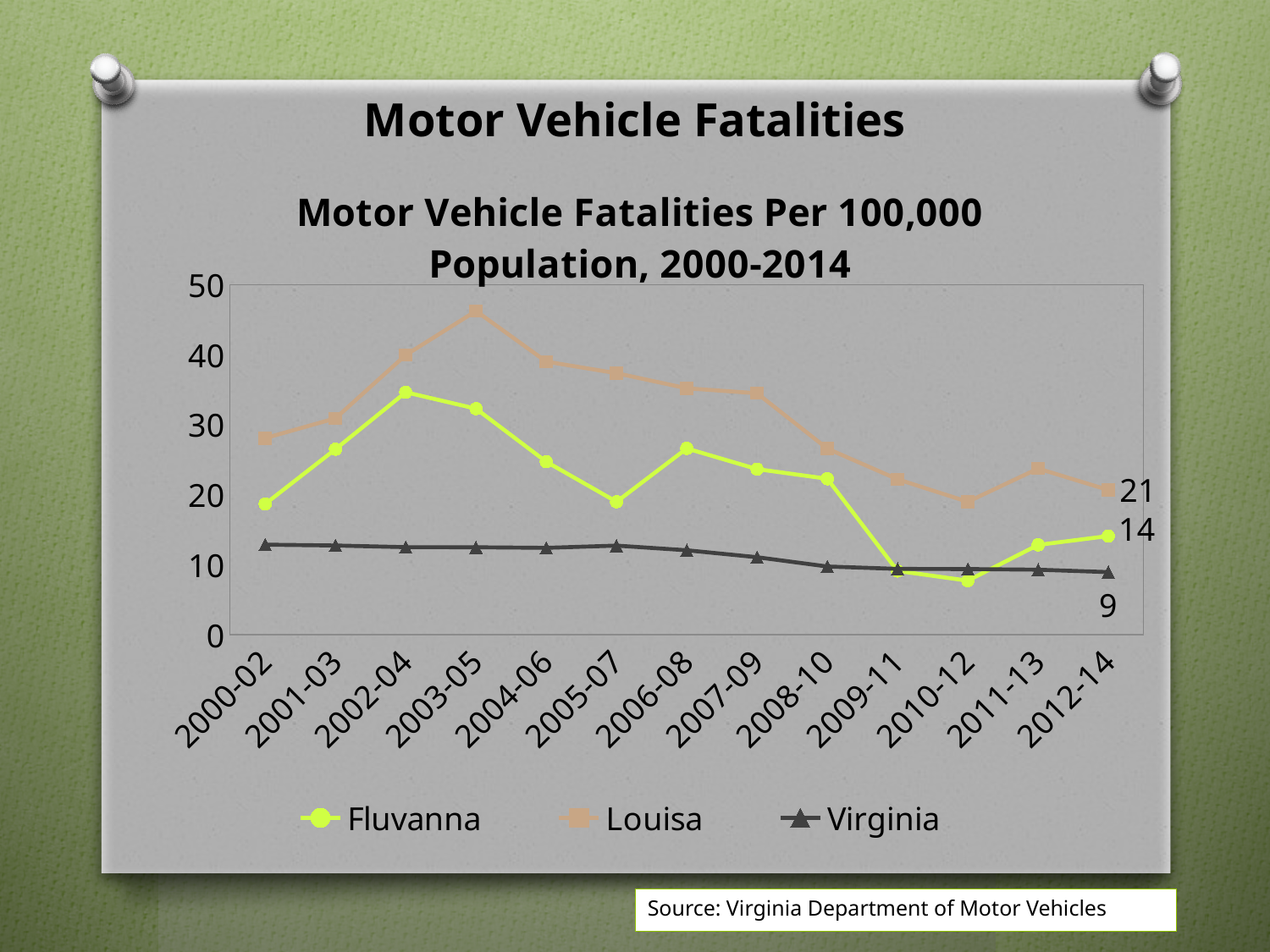
Is the value for Louisa in 2003-05 greater or less than 40? greater In 2012-14, which is larger, the Louisa value or the Virginia value? Louisa How many series does the legend list? 3 What is the value for Fluvanna in 2012-14? 14 What is the value for Louisa in 2012-14? 21 What kind of chart is shown on the slide? Line chart Is the value for Fluvanna in 2010-12 greater or less than 10? less How many time periods are shown along the x axis? 13 What is the difference between the Louisa and Fluvanna values in 2012-14? 7 Does the Virginia series generally rise or fall from 2000-02 to 2012-14? fall In which period does the Louisa series reach its highest value? 2003-05 What is the value for Virginia in 2012-14? 9